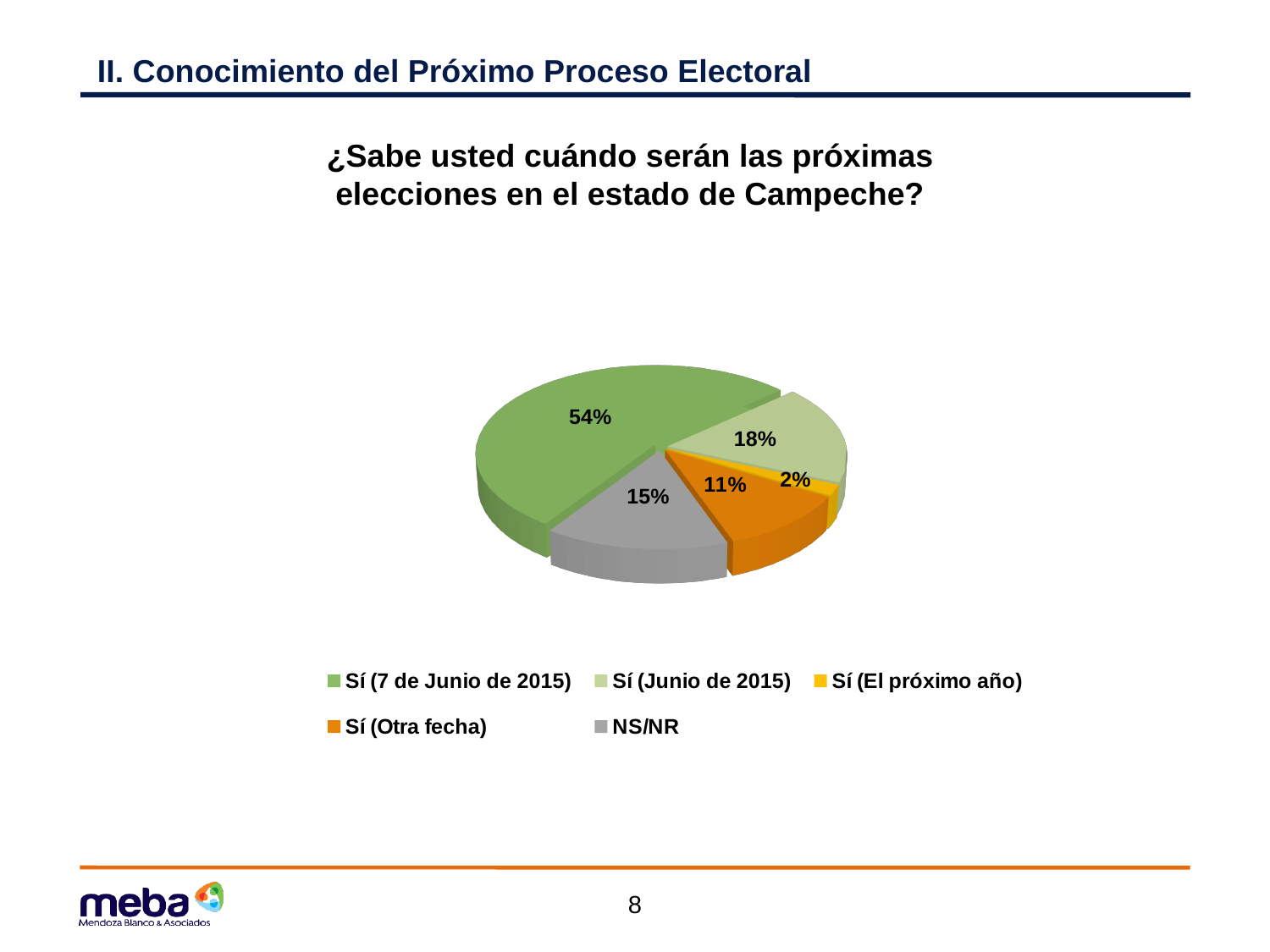
What colour is the slice representing "NS/NR"? gray What percentage of respondents answered "Sí (El próximo año)"? 2% Which response category has the largest share of the pie? Sí (7 de Junio de 2015) Which is larger, the share for "NS/NR" or the share for "Sí (Otra fecha)"? NS/NR What percentage of respondents answered "Sí (7 de Junio de 2015)"? 54% How many categories does the legend of the pie chart list? 5 What percentage of respondents answered "Sí (Junio de 2015)"? 18% Which response category has the smallest share of the pie? Sí (El próximo año) What kind of chart is shown on the slide? pie chart What percentage of respondents answered "Sí (Otra fecha)"? 11% What is the difference in percentage points between "Sí (7 de Junio de 2015)" and "Sí (Junio de 2015)"? 36 What percentage of respondents answered "NS/NR"? 15%